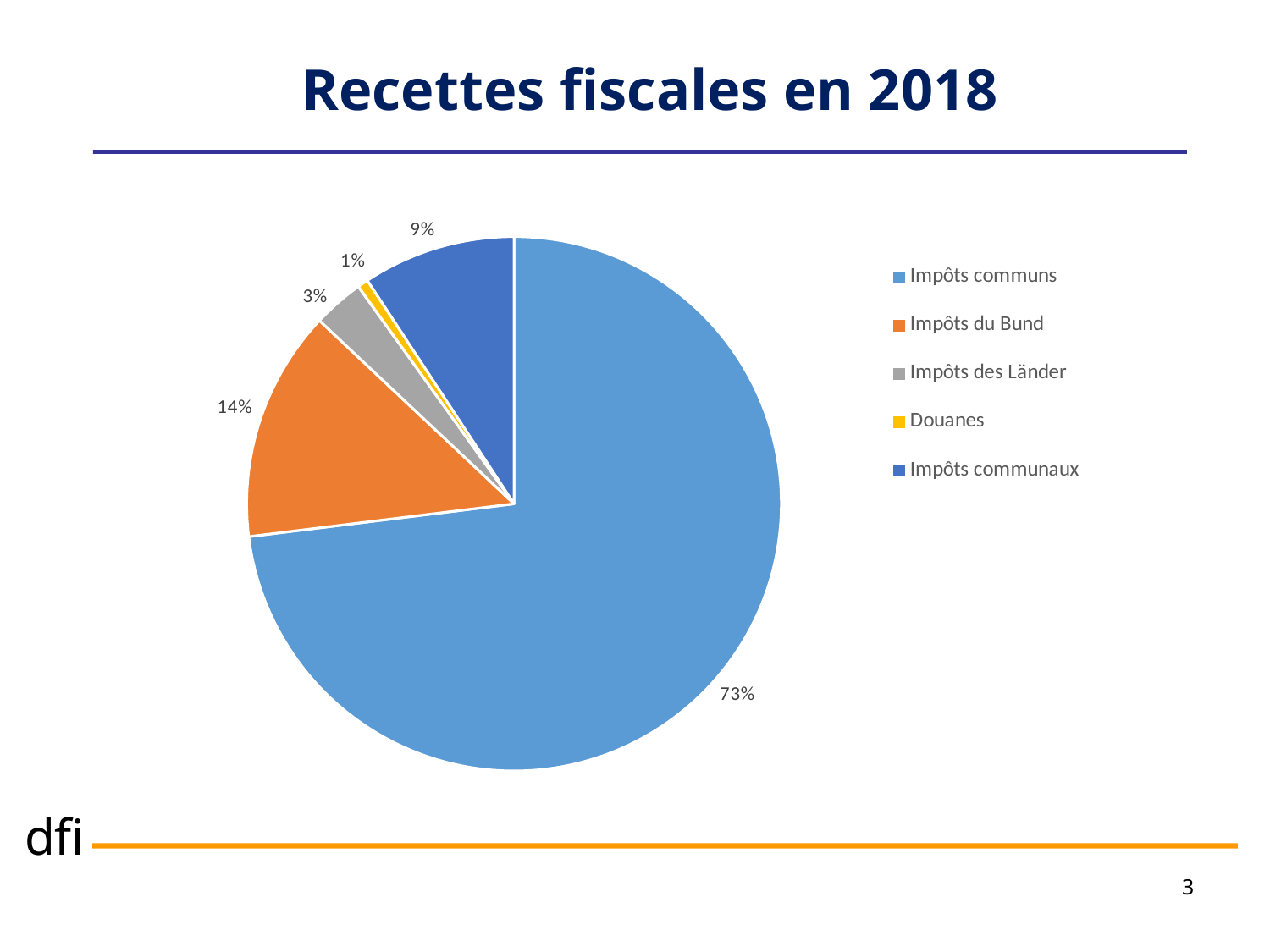
Which is larger, Impôts du Bund or Impôts communaux? Impôts du Bund What share of the pie does Impôts communaux represent? 9% Which category has the smallest slice of the pie? Douanes What share of the pie does Douanes represent? 1% What type of chart is shown on the slide? Pie chart What is the difference in percentage points between Impôts communs and Impôts du Bund? 59 How many categories does the pie chart show? 5 What share of the pie does Impôts du Bund represent? 14% What is the title of the chart? Recettes fiscales en 2018 What share of the pie does Impôts communs represent? 73% What share of the pie does Impôts des Länder represent? 3% Which category has the largest slice of the pie? Impôts communs